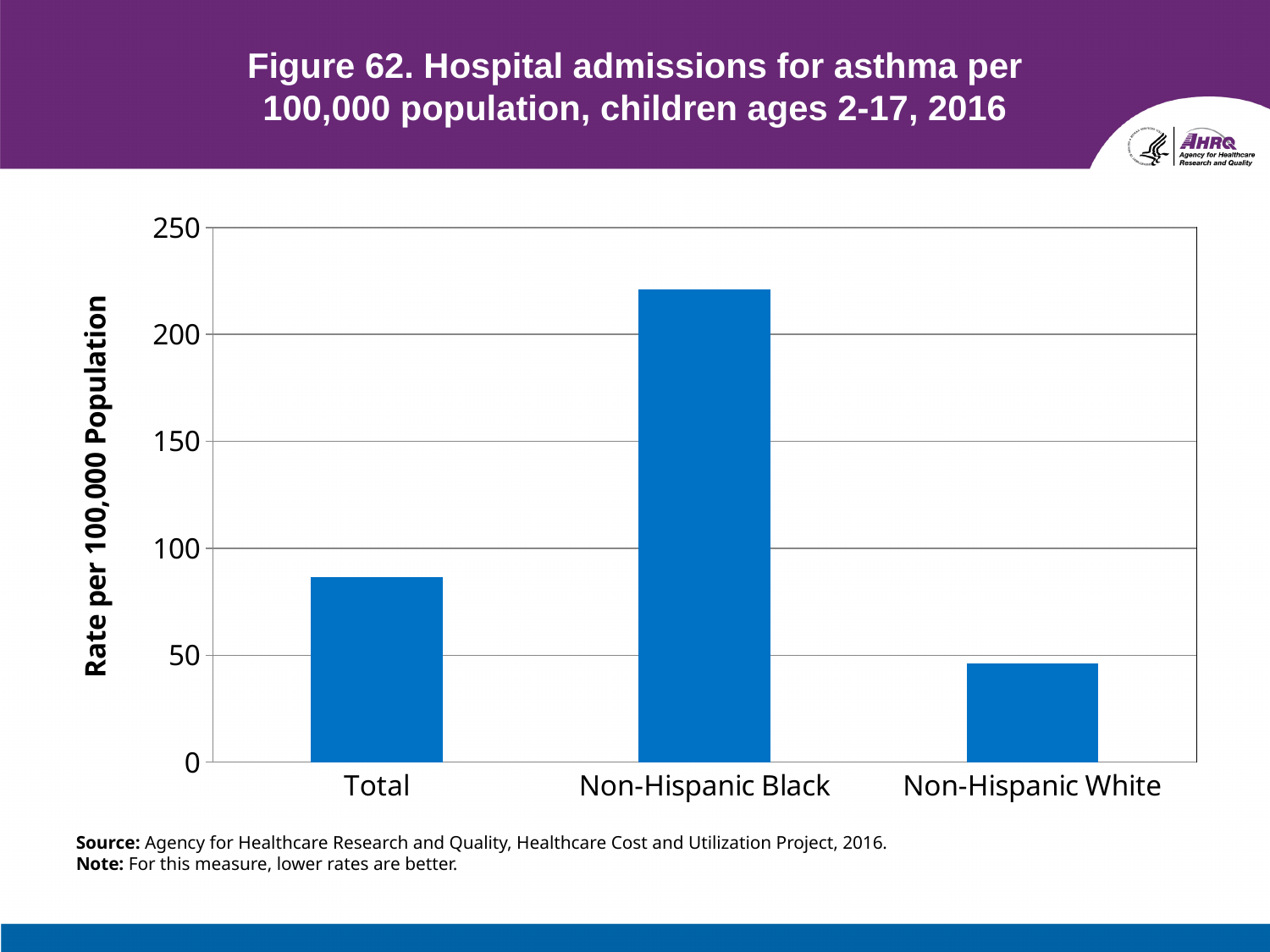
Which is larger, the value for Total or the value for Non-Hispanic White? Total Which category has the lowest hospital admission rate? Non-Hispanic White Is the value for Non-Hispanic White greater or less than 50? less Is the value for Total greater or less than 100? less Which category has the highest hospital admission rate? Non-Hispanic Black How many categories are plotted on the x axis? 3 Is the value for Non-Hispanic Black greater or less than 200? greater What is the maximum value shown on the y axis? 250 What is the label of the y axis? Rate per 100,000 Population Which is larger, the value for Non-Hispanic Black or the value for Total? Non-Hispanic Black What kind of chart is shown on the slide? bar chart